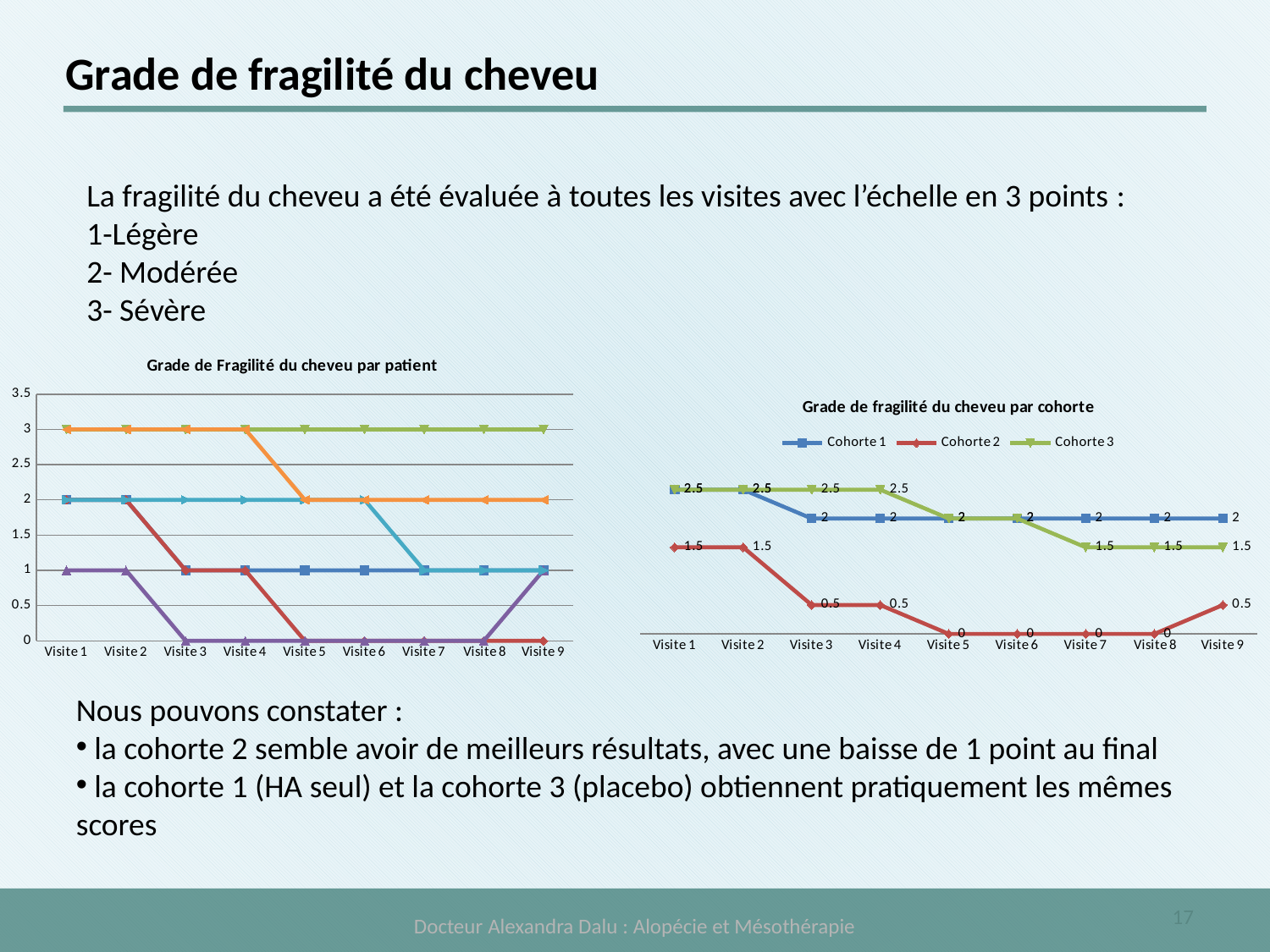
In the chart titled 'Grade de fragilité du cheveu par cohorte', how many series does the legend list? 3 In the chart titled 'Grade de fragilité du cheveu par cohorte', what is the value for Cohorte 2 at Visite 1? 1.5 What kind of chart is the chart titled 'Grade de Fragilité du cheveu par patient'? line chart In the chart titled 'Grade de fragilité du cheveu par cohorte', is the value for Cohorte 1 or Cohorte 3 larger at Visite 4? Cohorte 3 In the chart titled 'Grade de fragilité du cheveu par cohorte', what is the difference between Cohorte 1 and Cohorte 2 at Visite 1? 1 In the chart titled 'Grade de fragilité du cheveu par cohorte', which cohort has the lowest value at Visite 9? Cohorte 2 In the chart titled 'Grade de fragilité du cheveu par cohorte', what is the value for Cohorte 1 at Visite 3? 2 In the chart titled 'Grade de fragilité du cheveu par cohorte', which cohort has the highest value at Visite 9? Cohorte 1 In the chart titled 'Grade de fragilité du cheveu par cohorte', what is the value for Cohorte 3 at Visite 9? 1.5 In the chart titled 'Grade de fragilité du cheveu par cohorte', what is the value for Cohorte 2 at Visite 6? 0 In the chart titled 'Grade de fragilité du cheveu par cohorte', does the value for Cohorte 2 rise or fall from Visite 1 to Visite 5? fall How many visits are shown on the x axis of the chart titled 'Grade de Fragilité du cheveu par patient'? 9